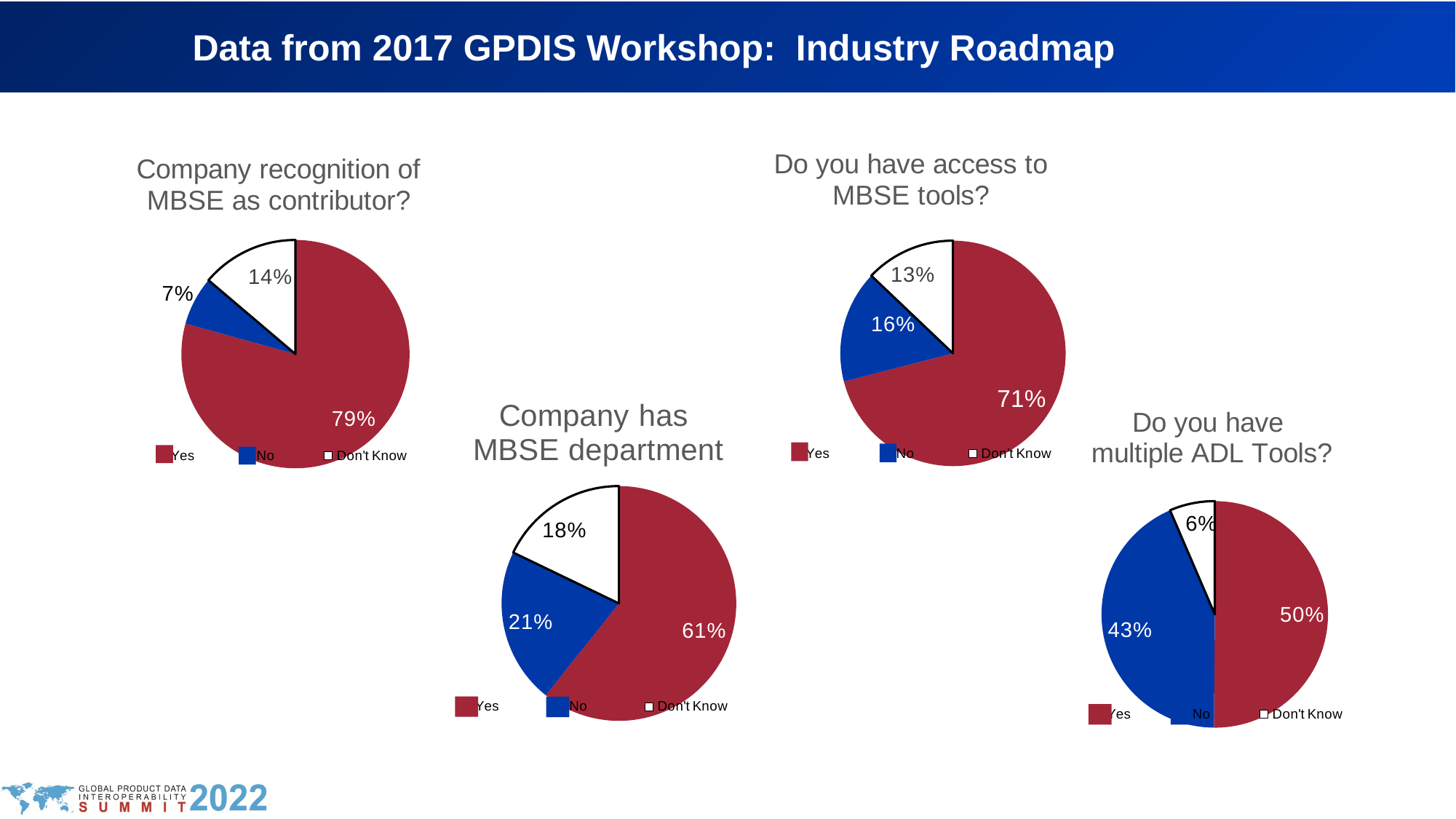
In the 'Do you have multiple ADL Tools?' chart, which response has the smallest share? Don't Know In the 'Company recognition of MBSE as contributor?' chart, which is larger, the No share or the Don't Know share? Don't Know In the 'Do you have access to MBSE tools?' chart, what percentage answered Don't Know? 13% How many pie charts are shown on the slide? 4 In the 'Company recognition of MBSE as contributor?' chart, what percentage answered Yes? 79% In the 'Company recognition of MBSE as contributor?' chart, what percentage answered No? 7% What type of chart is used for 'Do you have access to MBSE tools?' Pie chart In the 'Company has MBSE department' chart, which response has the largest share? Yes How many entries does the legend of the 'Company has MBSE department' chart list? 3 In the 'Do you have multiple ADL Tools?' chart, what percentage answered Yes? 50% In the 'Company has MBSE department' chart, what percentage answered No? 21% In the 'Do you have access to MBSE tools?' chart, what is the difference between the Yes and No percentages? 55%